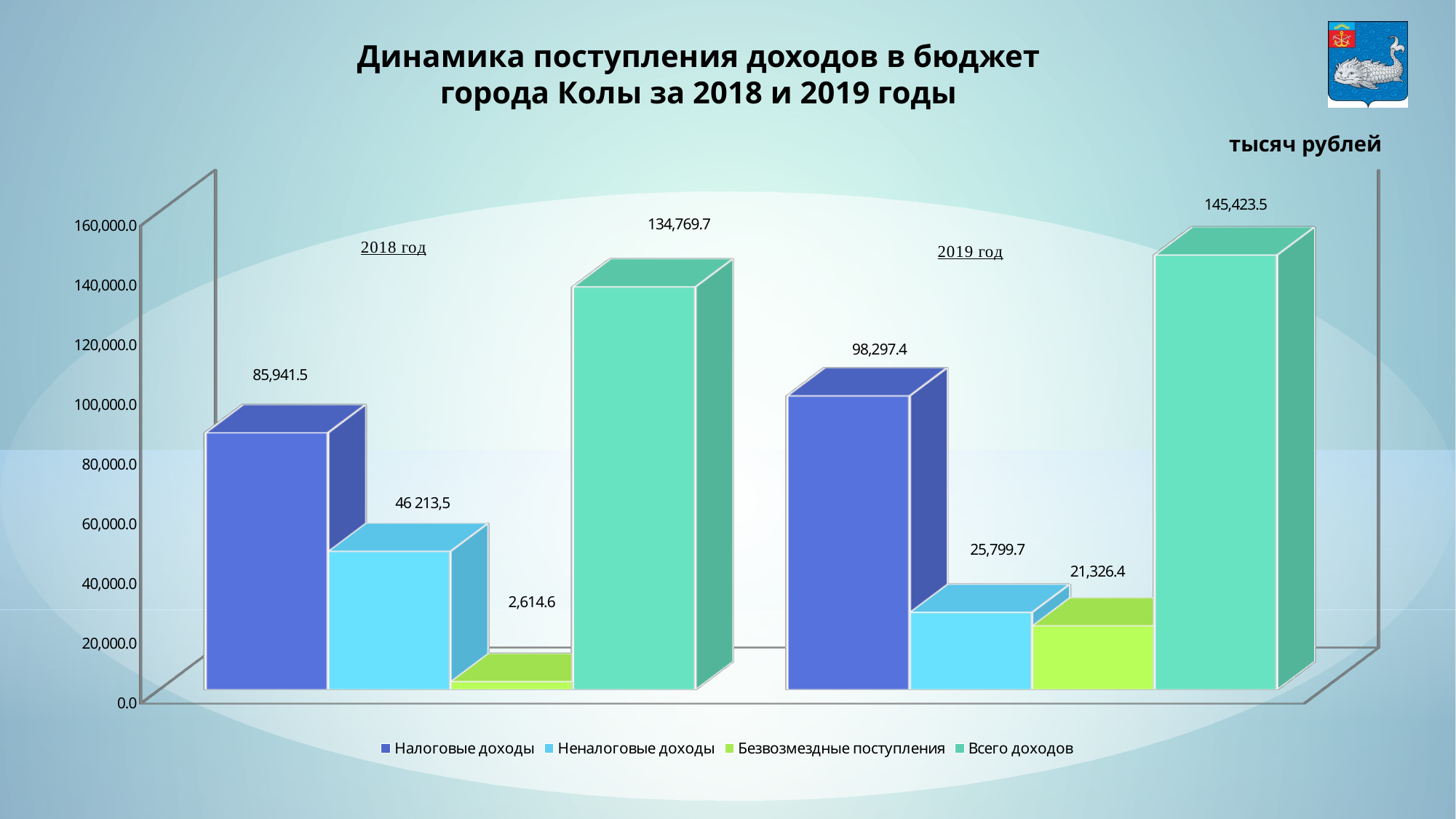
What is the difference between Всего доходов in 2019 год and in 2018 год? 10,653.8 What kind of chart is shown on the slide? bar chart What is the value of Всего доходов for 2019 год? 145,423.5 What is the value of Налоговые доходы for 2018 год? 85,941.5 What unit is indicated for the values on the chart? тысяч рублей What is the value of Неналоговые доходы for 2018 год? 46 213,5 Which series has the lowest value in 2018 год? Безвозмездные поступления Which series has the highest value in 2019 год? Всего доходов Which is larger: Неналоговые доходы in 2018 год or Неналоговые доходы in 2019 год? 2018 год How many series does the legend list? 4 Is the value of Налоговые доходы for 2019 год greater or less than 100,000.0? less What is the value of Безвозмездные поступления for 2019 год? 21,326.4